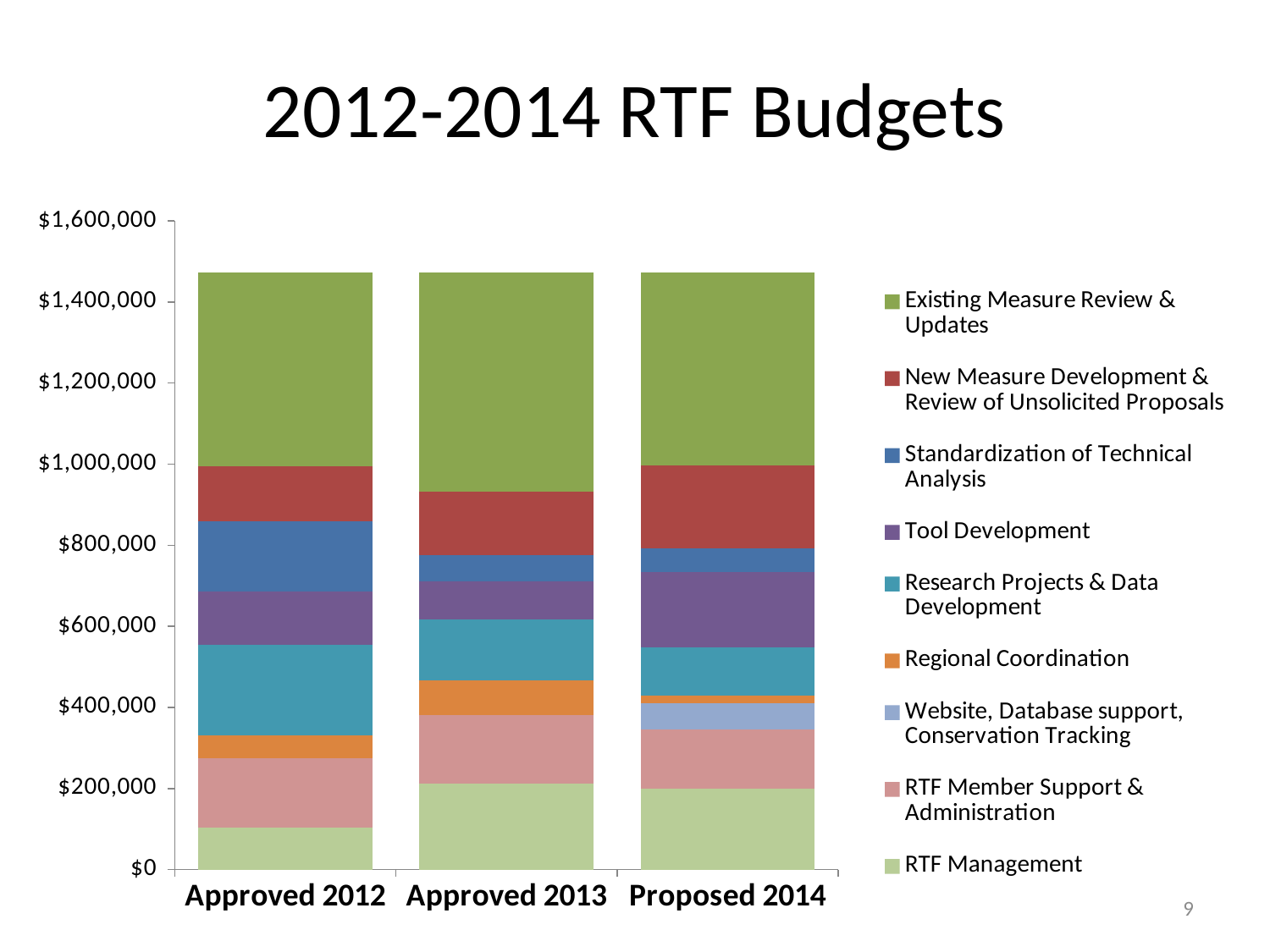
What kind of chart is shown on the slide? Stacked bar chart Is the total budget for Approved 2012 greater or less than $1,400,000? greater Is the RTF Management value for Approved 2012 greater or less than $200,000? less Which year has the largest Existing Measure Review & Updates segment? Approved 2013 What is the title of the chart? 2012-2014 RTF Budgets How many budget years (categories) are shown on the x axis? 3 Is the Standardization of Technical Analysis segment larger for Approved 2012 or Approved 2013? Approved 2012 Which series appears only in the Proposed 2014 bar and not in the other two bars? Website, Database support, Conservation Tracking How many series does the legend list? 9 Is the Existing Measure Review & Updates value for Approved 2013 greater or less than $400,000? greater Which year has the smallest Regional Coordination segment? Proposed 2014 Is the Tool Development segment larger for Approved 2013 or Proposed 2014? Proposed 2014